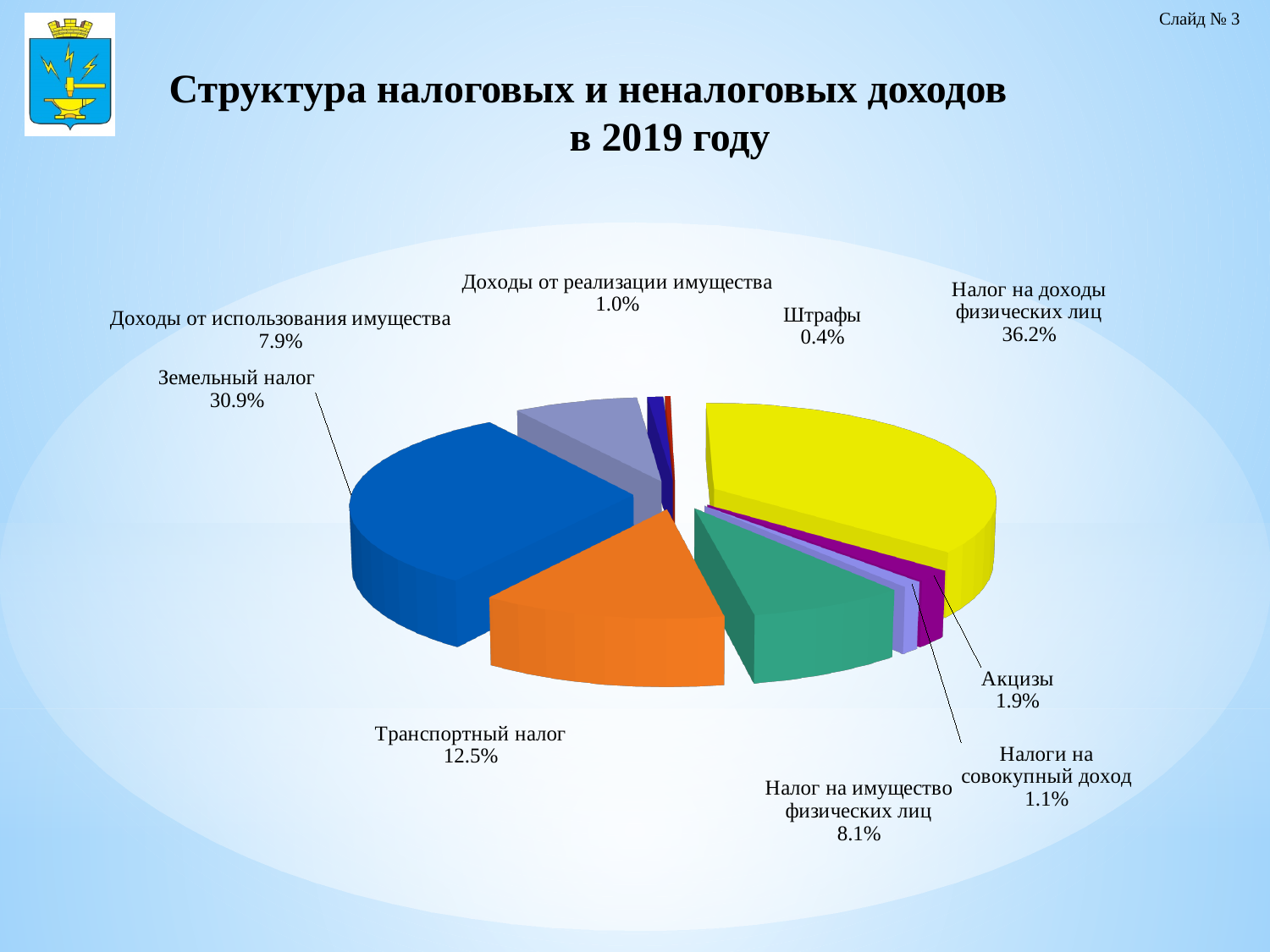
What is the value shown for "Транспортный налог"? 12.5% What kind of chart is shown on the slide? Pie chart What is the value shown for "Земельный налог"? 30.9% What is the title of the chart on the slide? Структура налоговых и неналоговых доходов в 2019 году What is the value shown for "Штрафы"? 0.4% Which category has the largest share of the pie? Налог на доходы физических лиц What is the value shown for "Налог на имущество физических лиц"? 8.1% How many categories (slices) does the pie chart have? 9 Which is larger: the share of "Доходы от использования имущества" or the share of "Налог на имущество физических лиц"? Налог на имущество физических лиц What is the difference between the shares of "Налог на доходы физических лиц" and "Земельный налог"? 5.3% Which category has the smallest share of the pie? Штрафы What share of the pie does "Налог на доходы физических лиц" have? 36.2%